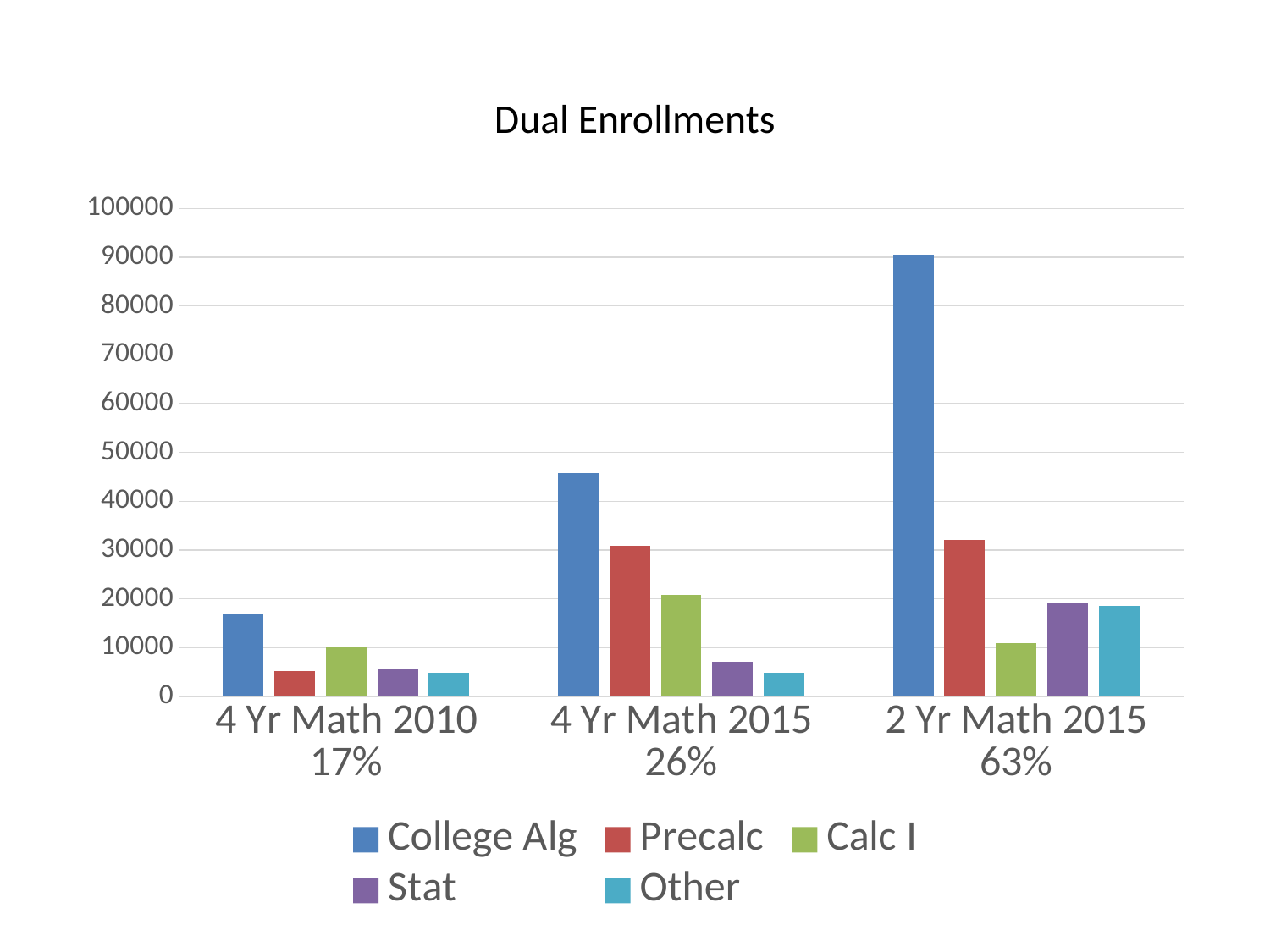
How many series does the legend list? 5 Is the value for College Alg in 2 Yr Math 2015 greater or less than 80000? greater Which series has the lowest value in the 4 Yr Math 2015 category? Other Is the value for College Alg in 4 Yr Math 2015 greater or less than 40000? greater Does the College Alg value rise or fall from 4 Yr Math 2010 to 2 Yr Math 2015 along the x axis? rise Is the value for Calc I in 4 Yr Math 2015 greater or less than 30000? less What is the title of the chart? Dual Enrollments Which is larger, the Stat value in 2 Yr Math 2015 or the Calc I value in 2 Yr Math 2015? Stat Which series has the highest value in the 2 Yr Math 2015 category? College Alg How many categories are shown on the x axis? 3 What type of chart is shown on the slide? bar chart